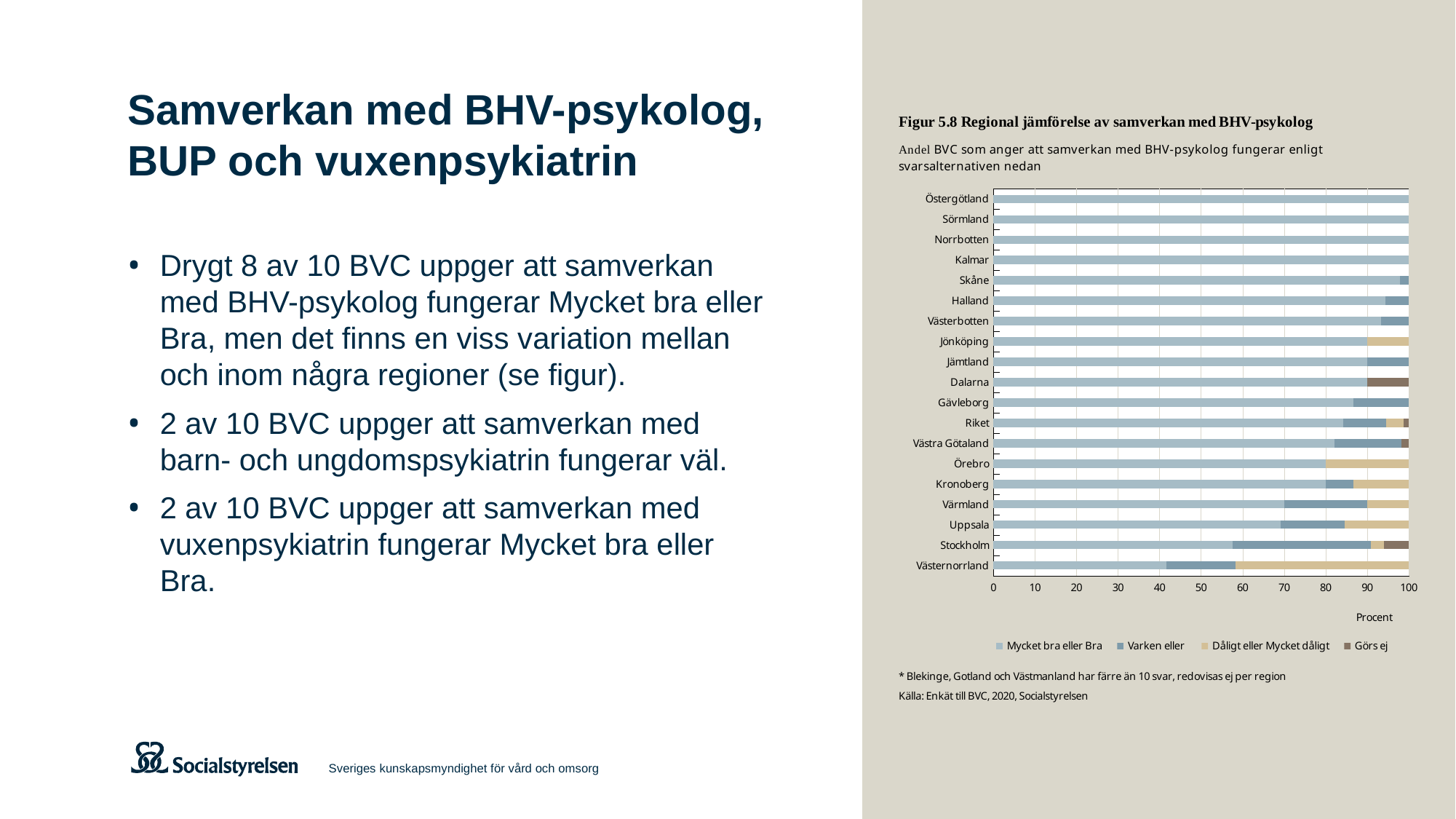
How many series does the legend of the chart list? 4 Is the 'Mycket bra eller Bra' value for Västernorrland greater or less than 50? less Which has a larger 'Mycket bra eller Bra' share, Stockholm or Västernorrland? Stockholm Which region has the largest 'Dåligt eller Mycket dåligt' segment? Västernorrland Is the 'Mycket bra eller Bra' value for Stockholm greater or less than 50? greater What kind of chart is shown in Figur 5.8? Stacked bar chart Is the 'Mycket bra eller Bra' value for Halland greater or less than 90? greater How many regions (categories) are plotted in the chart? 19 Which region has the lowest share for 'Mycket bra eller Bra'? Västernorrland What is the title of the figure on the slide? Figur 5.8 Regional jämförelse av samverkan med BHV-psykolog What is the label of the horizontal axis of the chart? Procent